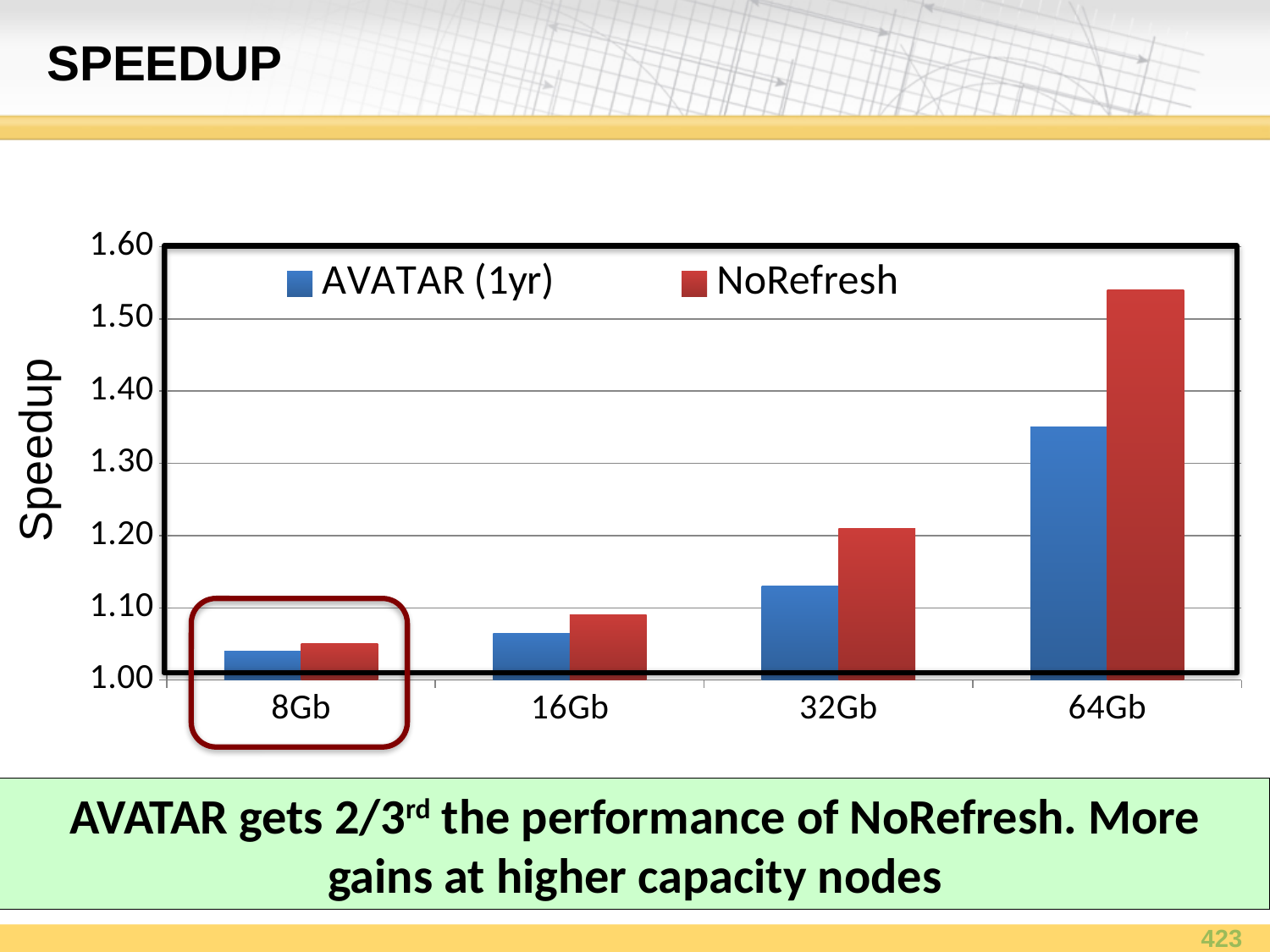
Is the AVATAR (1yr) speedup at 16Gb greater or less than 1.10? less At 64Gb, which series has the larger speedup, AVATAR (1yr) or NoRefresh? NoRefresh Which capacity has the lowest AVATAR (1yr) speedup? 8Gb Do the NoRefresh speedup values rise or fall as capacity increases from 8Gb to 64Gb? rise What is the label on the y axis of the chart? Speedup How many series does the legend list? 2 How many capacity categories are shown on the x axis? 4 Which capacity has the highest NoRefresh speedup? 64Gb What kind of chart is shown on the slide? bar chart Is the NoRefresh speedup at 64Gb greater or less than 1.50? greater Is the AVATAR (1yr) speedup at 64Gb greater or less than 1.40? less